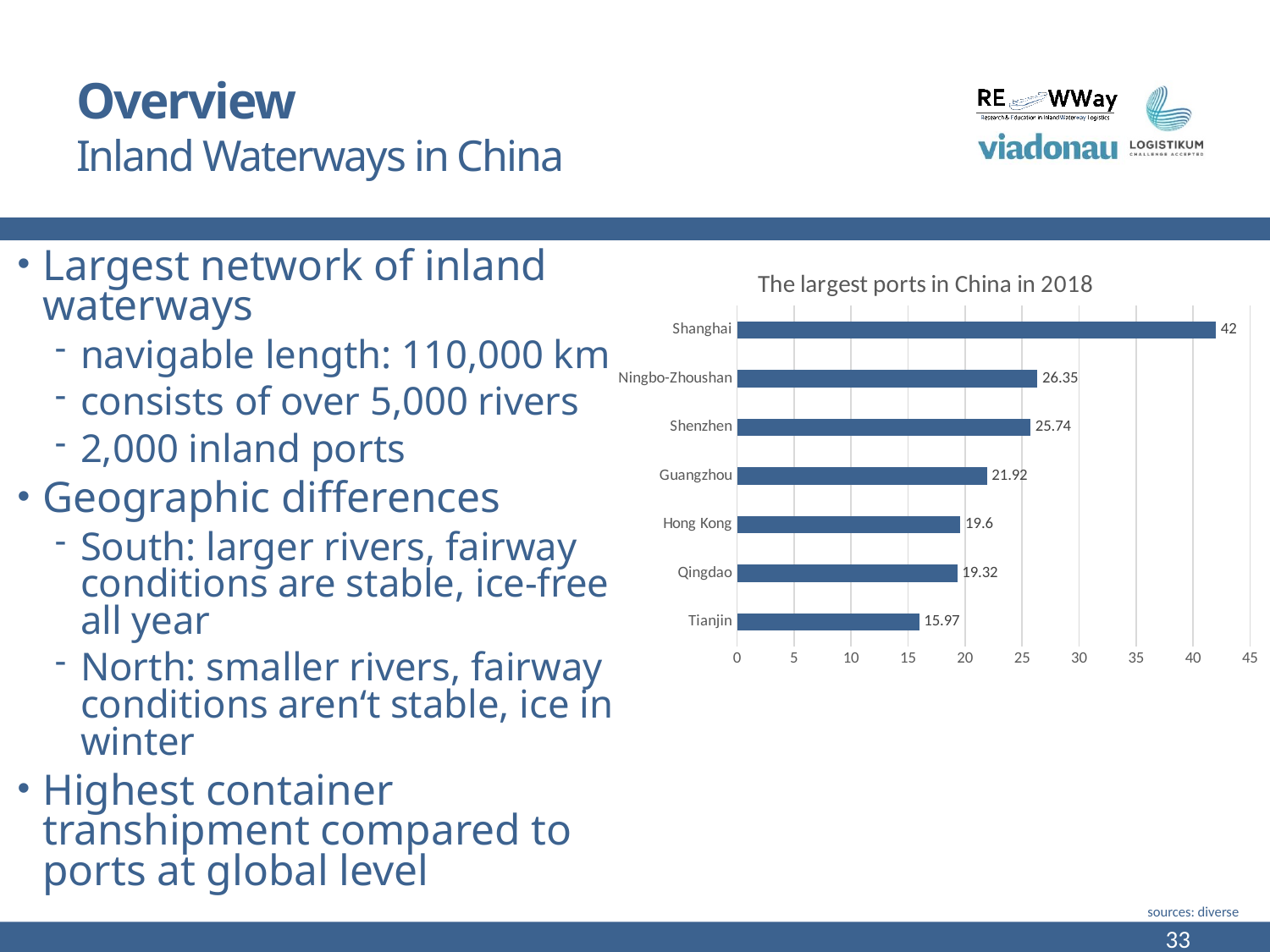
How many ports are shown in the chart? 7 What kind of chart is shown on the slide? bar chart What is the difference between the values for Shanghai and Ningbo-Zhoushan? 15.65 Which port has the lowest value? Tianjin Is the value for Qingdao greater or less than 20? less Which is larger, the value for Shenzhen or the value for Guangzhou? Shenzhen What is the value for Ningbo-Zhoushan? 26.35 What is the title of the chart? The largest ports in China in 2018 What is the value for Tianjin? 15.97 Which port has the highest value? Shanghai What is the value for Shanghai? 42 What is the difference between the values for Guangzhou and Hong Kong? 2.32